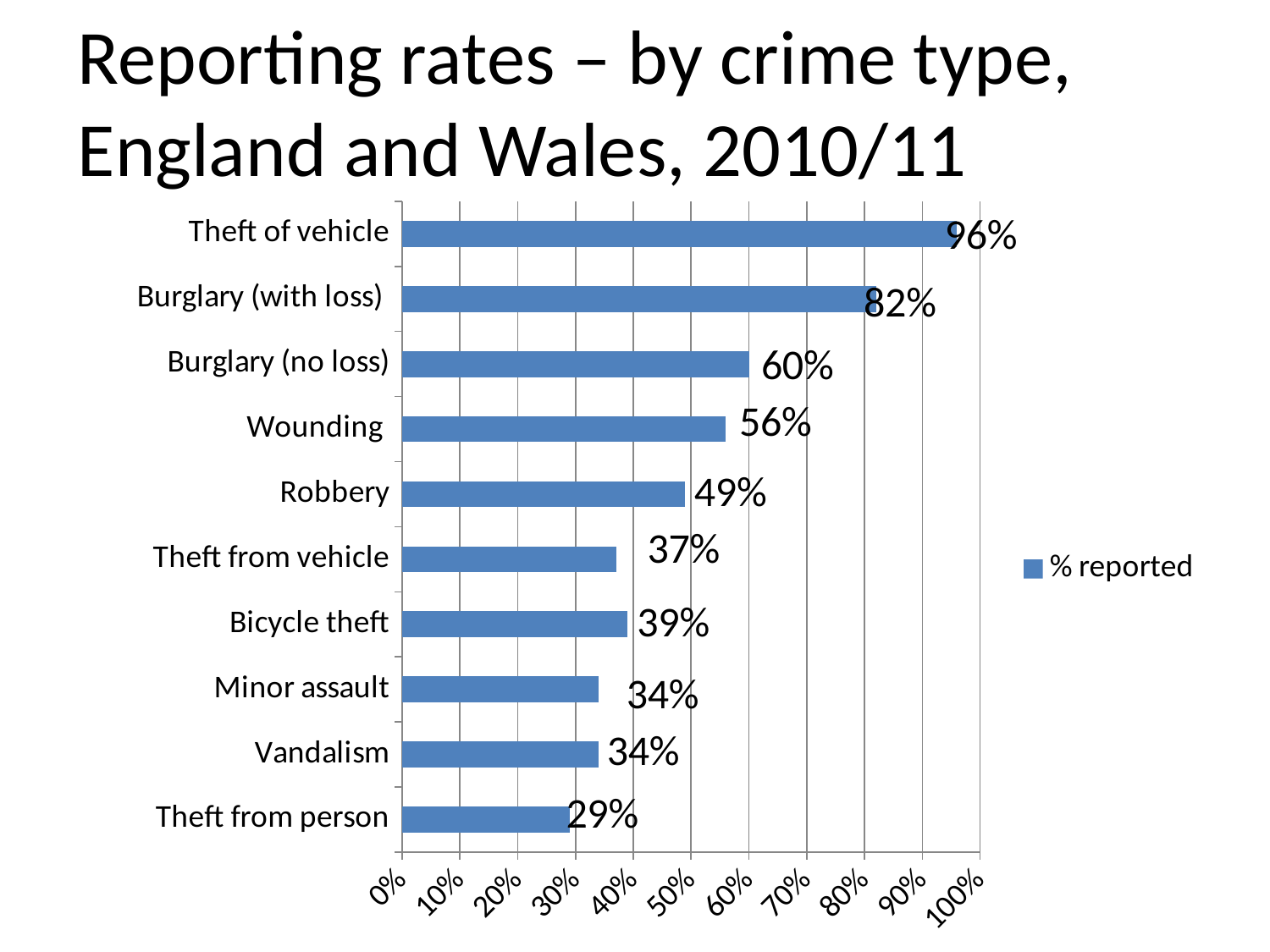
Is the reporting rate for Theft from vehicle greater or less than 50%? less What is the reporting rate for Bicycle theft? 39% What is the reporting rate for Robbery? 49% What series name is shown in the chart legend? % reported Which crime type has the highest reporting rate? Theft of vehicle What kind of chart is shown on the slide? Bar chart What is the difference in reporting rate between Theft of vehicle and Theft from person? 67% How many crime types are shown in the chart? 10 Which crime type has the lowest reporting rate? Theft from person What is the reporting rate for Theft of vehicle? 96% Which has a higher reporting rate, Wounding or Robbery? Wounding What is the difference in reporting rate between Burglary (with loss) and Burglary (no loss)? 22%